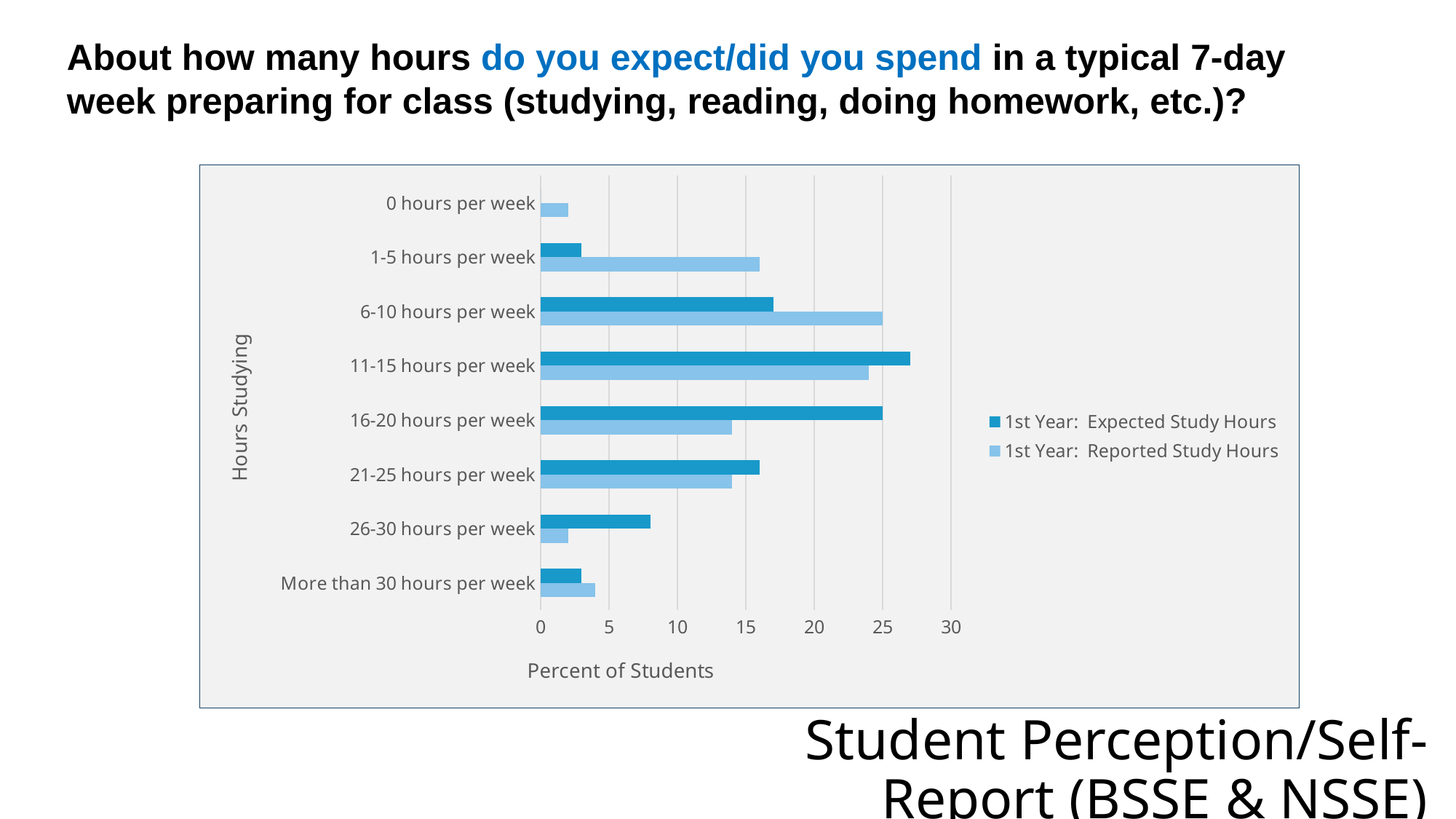
Which category has the highest value for 1st Year: Expected Study Hours? 11-15 hours per week Which category has the lowest value for 1st Year: Expected Study Hours? 0 hours per week Is the value for 1st Year: Expected Study Hours in the 26-30 hours per week category greater or less than 10? less For the 16-20 hours per week category, which is larger: Expected Study Hours or Reported Study Hours? Expected Study Hours Is the value for 1st Year: Expected Study Hours in the 11-15 hours per week category greater or less than 25? greater Which category has the highest value for 1st Year: Reported Study Hours? 6-10 hours per week What is the label of the horizontal axis of the chart? Percent of Students What kind of chart is shown on the slide? bar chart For the 1-5 hours per week category, which is larger: Expected Study Hours or Reported Study Hours? Reported Study Hours How many series does the legend list? 2 Is the value for 1st Year: Reported Study Hours in the 1-5 hours per week category greater or less than 10? greater How many hours-studying categories are shown on the chart? 8